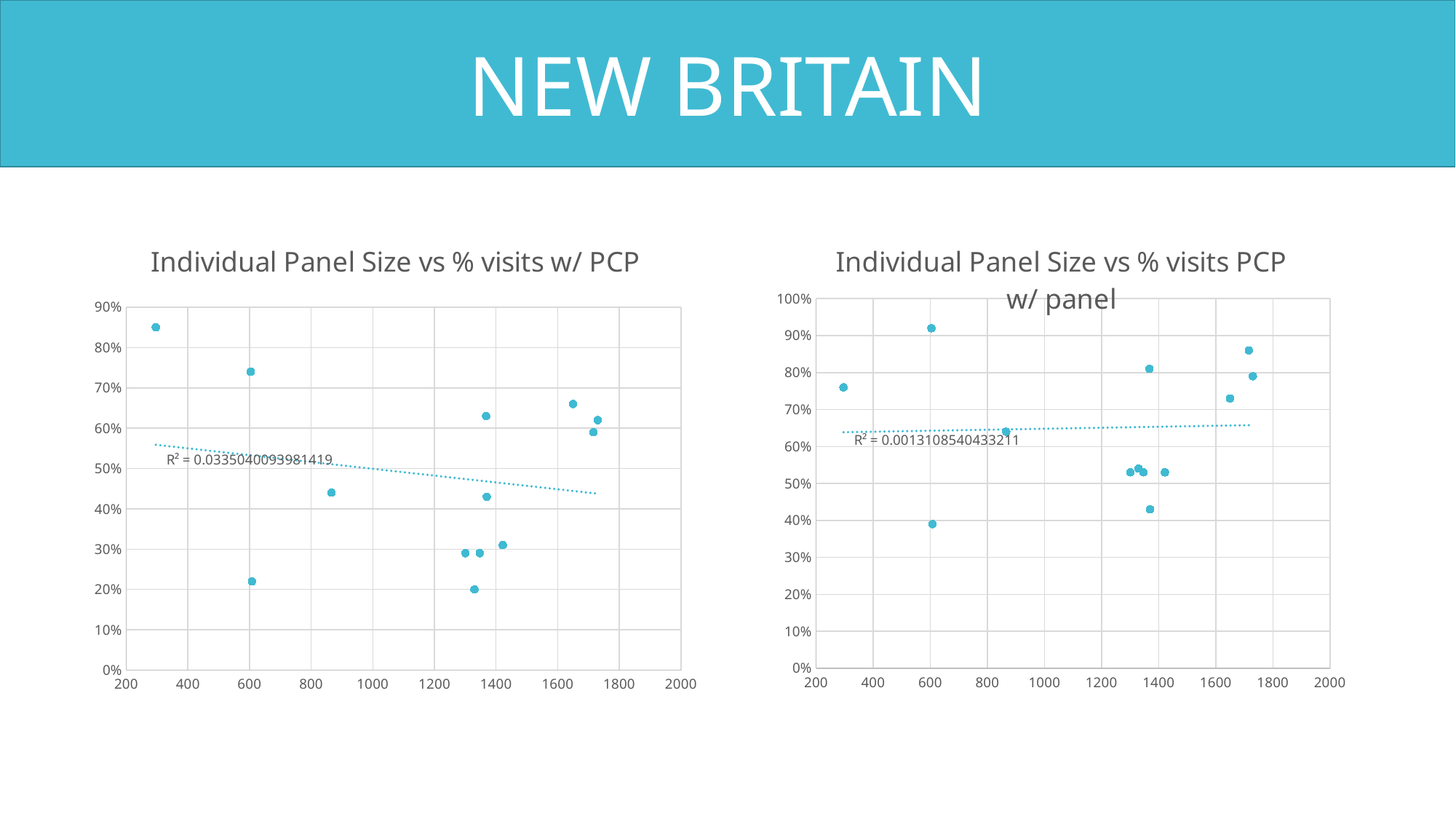
How many data points are plotted on the left chart, 'Individual Panel Size vs % visits w/ PCP'? 13 On the left chart, 'Individual Panel Size vs % visits w/ PCP', is the lowest plotted point greater or less than 30%? less On the right chart, 'Individual Panel Size vs % visits PCP w/ panel', is the highest plotted point greater or less than 80%? greater On the right chart, 'Individual Panel Size vs % visits PCP w/ panel', is the lowest plotted point greater or less than 50%? less What R² value is shown on the right chart, 'Individual Panel Size vs % visits PCP w/ panel'? R² = 0.0013108540433211 How many data points are plotted on the right chart, 'Individual Panel Size vs % visits PCP w/ panel'? 13 What is the maximum value shown on the vertical axis of the right chart, 'Individual Panel Size vs % visits PCP w/ panel'? 100% What R² value is shown on the left chart, 'Individual Panel Size vs % visits w/ PCP'? R² = 0.0335040093981419 On the left chart, 'Individual Panel Size vs % visits w/ PCP', does the dotted trendline rise or fall as panel size increases? Fall What kind of chart is the right chart, 'Individual Panel Size vs % visits PCP w/ panel'? Scatter chart What kind of chart is the left chart, 'Individual Panel Size vs % visits w/ PCP'? Scatter chart